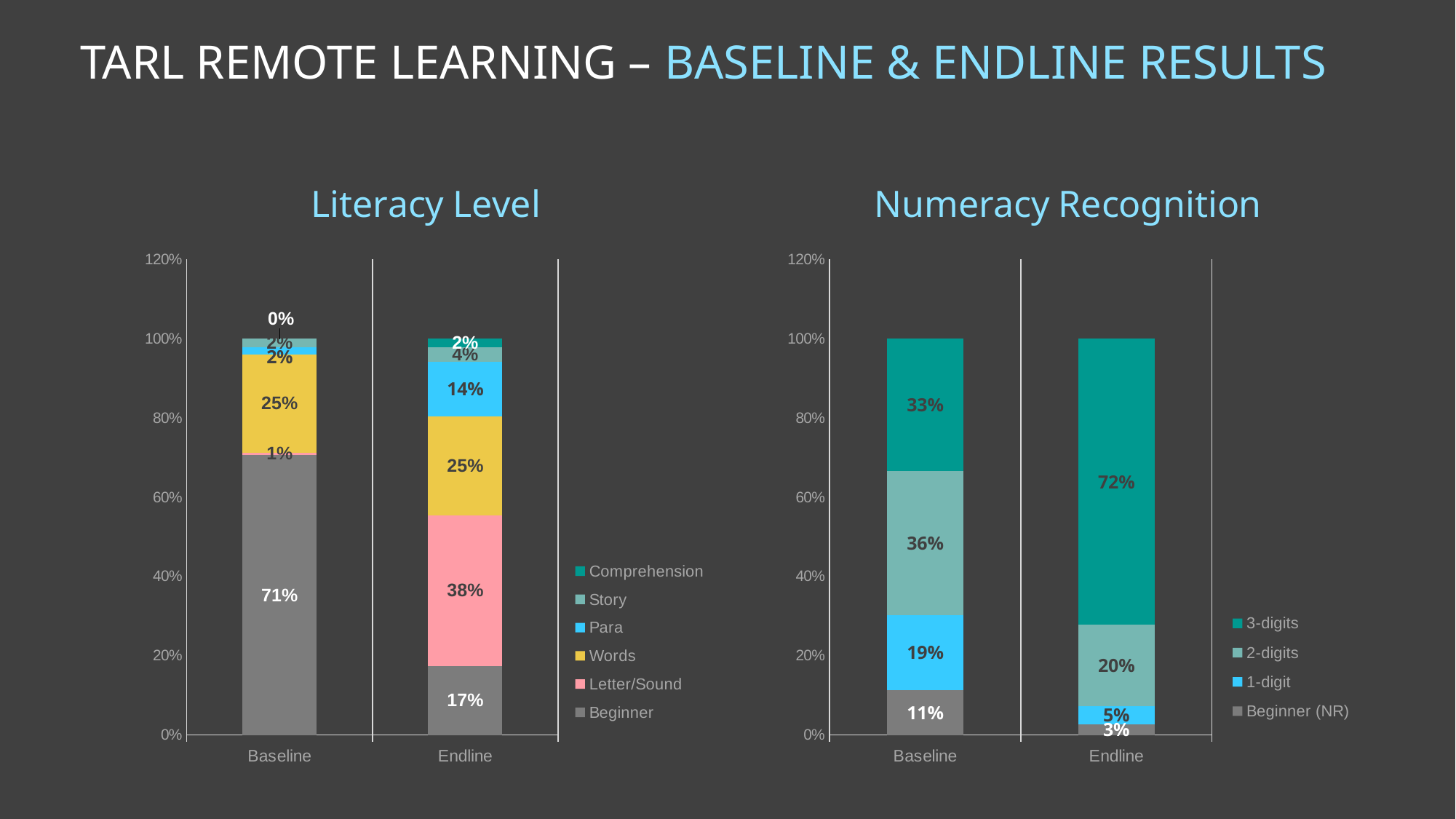
In the Numeracy Recognition chart, which segment is largest in the Baseline bar? 2-digits In the Literacy Level chart, what is the difference between the Beginner values for Baseline and Endline? 54% How many series does the legend of the Literacy Level chart list? 6 In the Numeracy Recognition chart, what is the 3-digits value for Endline? 72% In the Numeracy Recognition chart, is the Beginner (NR) value larger for Baseline or Endline? Baseline What type of chart is the Numeracy Recognition chart? Stacked bar chart In the Numeracy Recognition chart, what is the 1-digit value for Baseline? 19% In the Literacy Level chart, which segment is smallest in the Endline bar? Comprehension In the Numeracy Recognition chart, what is the difference between the 3-digits values for Endline and Baseline? 39% In the Literacy Level chart, what percentage of the Baseline bar is Beginner? 71% In the Literacy Level chart, what is the Para value for Endline? 14% In the Literacy Level chart, what is the Letter/Sound value for Endline? 38%